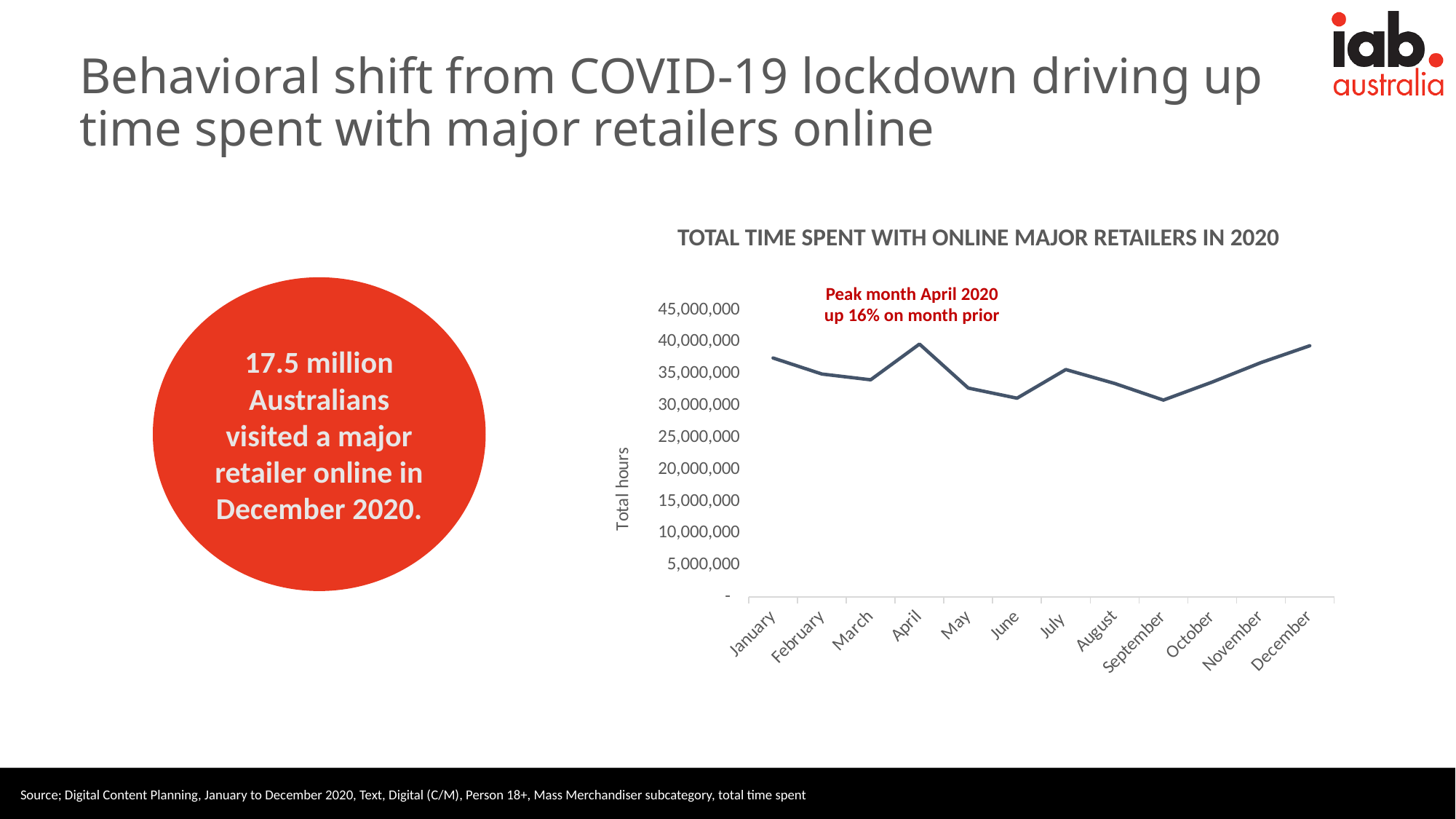
Is the value for September greater or less than 35,000,000? less How many months are plotted on the x axis of the chart? 12 Is the value for June greater or less than 35,000,000? less What is the title of the chart? TOTAL TIME SPENT WITH ONLINE MAJOR RETAILERS IN 2020 Is the value for January greater or less than 35,000,000? greater Which is larger, the value for September or the value for January? January Which month has the highest total time spent in the chart? April Does the line rise or fall from September to December? rise According to the annotation, by how much was the peak month April 2020 up on the month prior? 16% What kind of chart is shown on the slide? line chart Which is larger, the value for April or the value for June? April